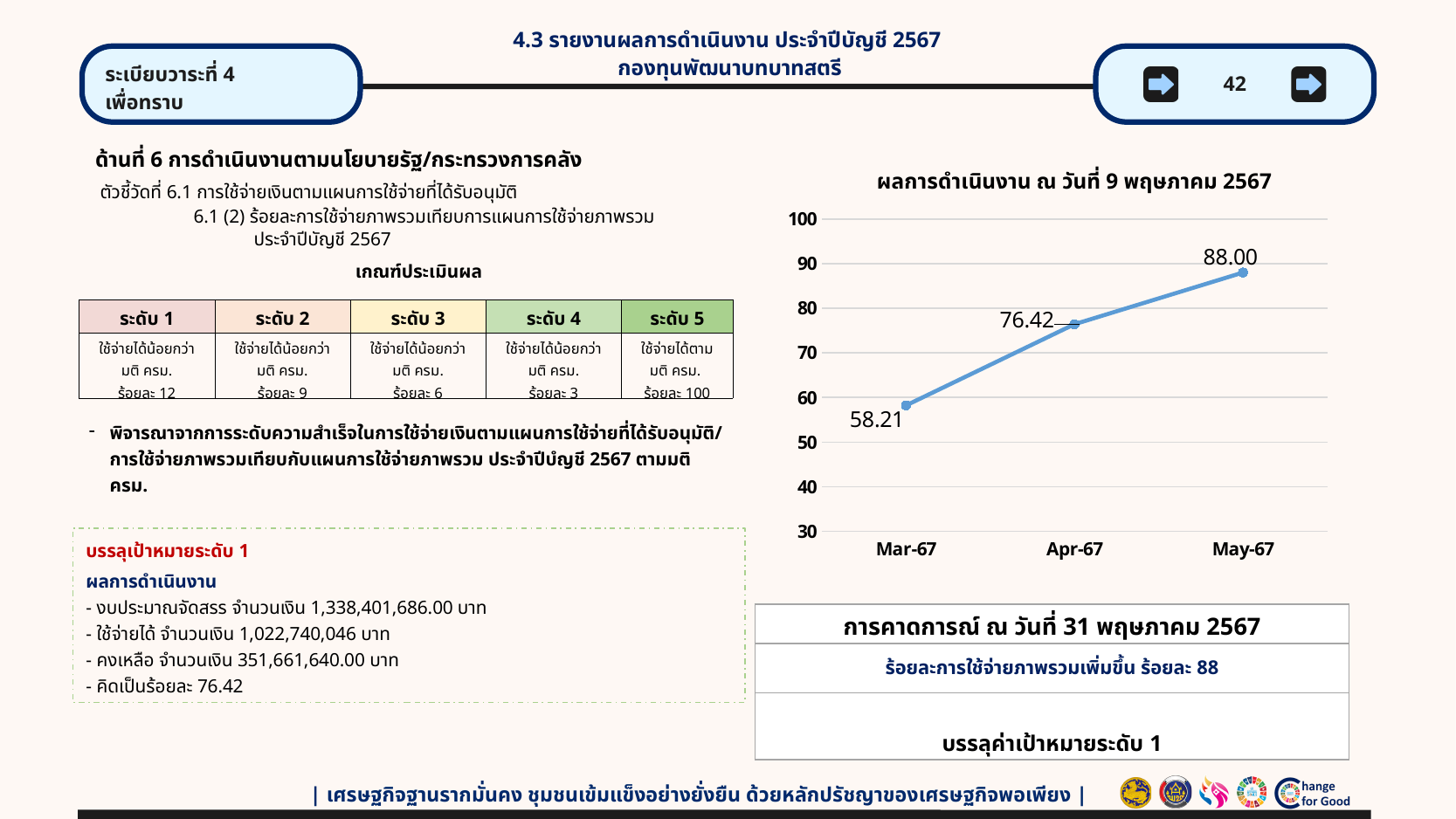
What is the value for May-67? 88.00 What is the value for Apr-67? 76.42 Which month has the lowest value? Mar-67 Which month has the highest value? May-67 Do the values rise or fall from Mar-67 to May-67? rise How many data points are plotted on the chart? 3 Which is larger, the value for Apr-67 or the value for May-67? May-67 What type of chart is shown on the slide? line chart Is the value for Mar-67 greater or less than 60? less What is the difference between the values for Apr-67 and Mar-67? 18.21 What is the value for Mar-67? 58.21 What is the difference between the values for May-67 and Mar-67? 29.79